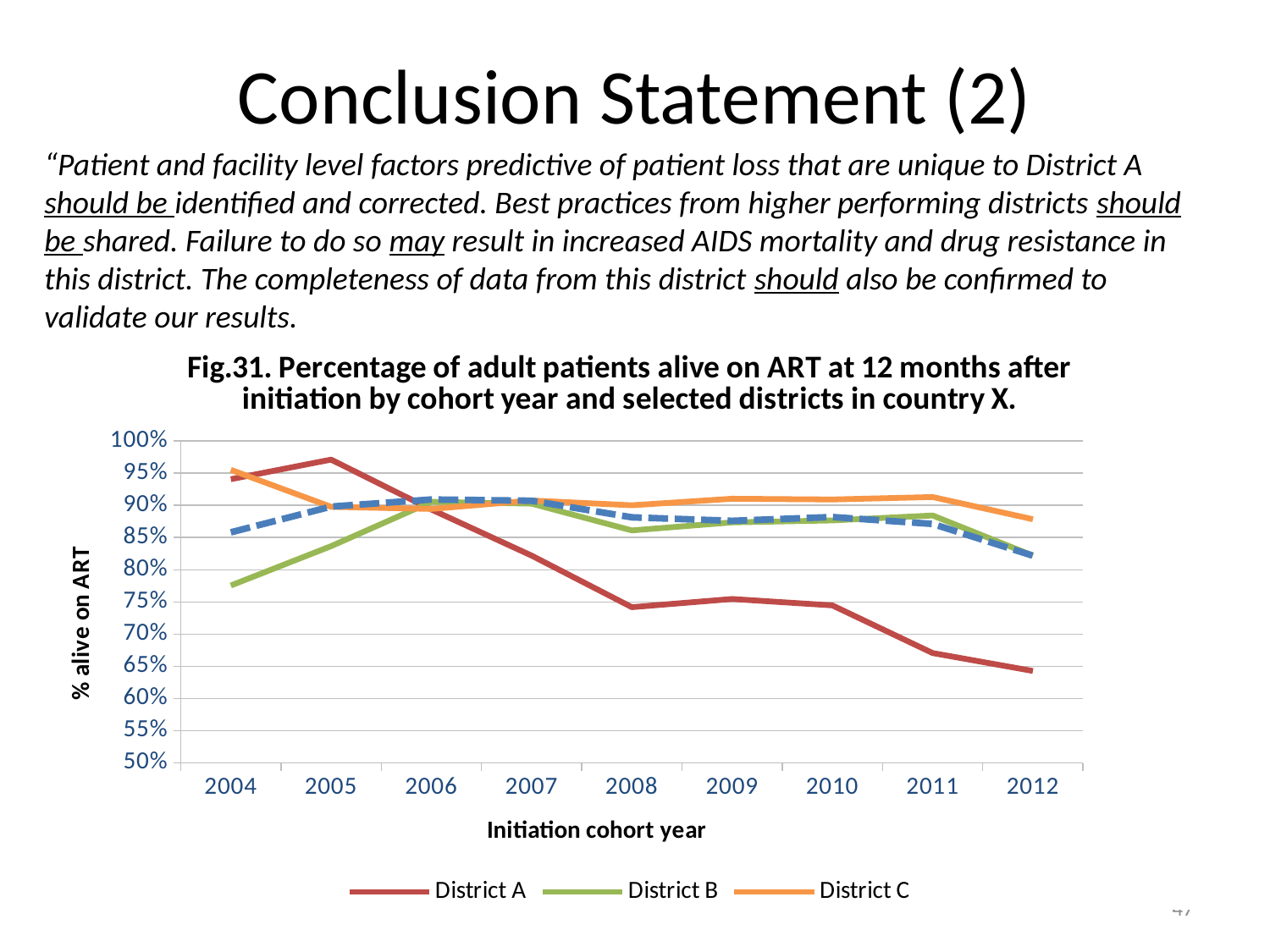
How many series does the legend of Fig.31 list? 3 What kind of chart is shown in Fig.31? line chart How many initiation cohort years are shown on the x axis of Fig.31? 9 What is the title of the x axis in Fig.31? Initiation cohort year Is the value for District A in 2005 greater or less than 95%? greater In 2012, which is higher: District A or District C? District C Is the value for District A in 2012 greater or less than 70%? less Does the value for District A rise or fall from 2004 to 2012? fall Is the value for District B in 2004 greater or less than 80%? less Which district has the lowest value in 2004? District B Which district has the highest value in 2012? District C